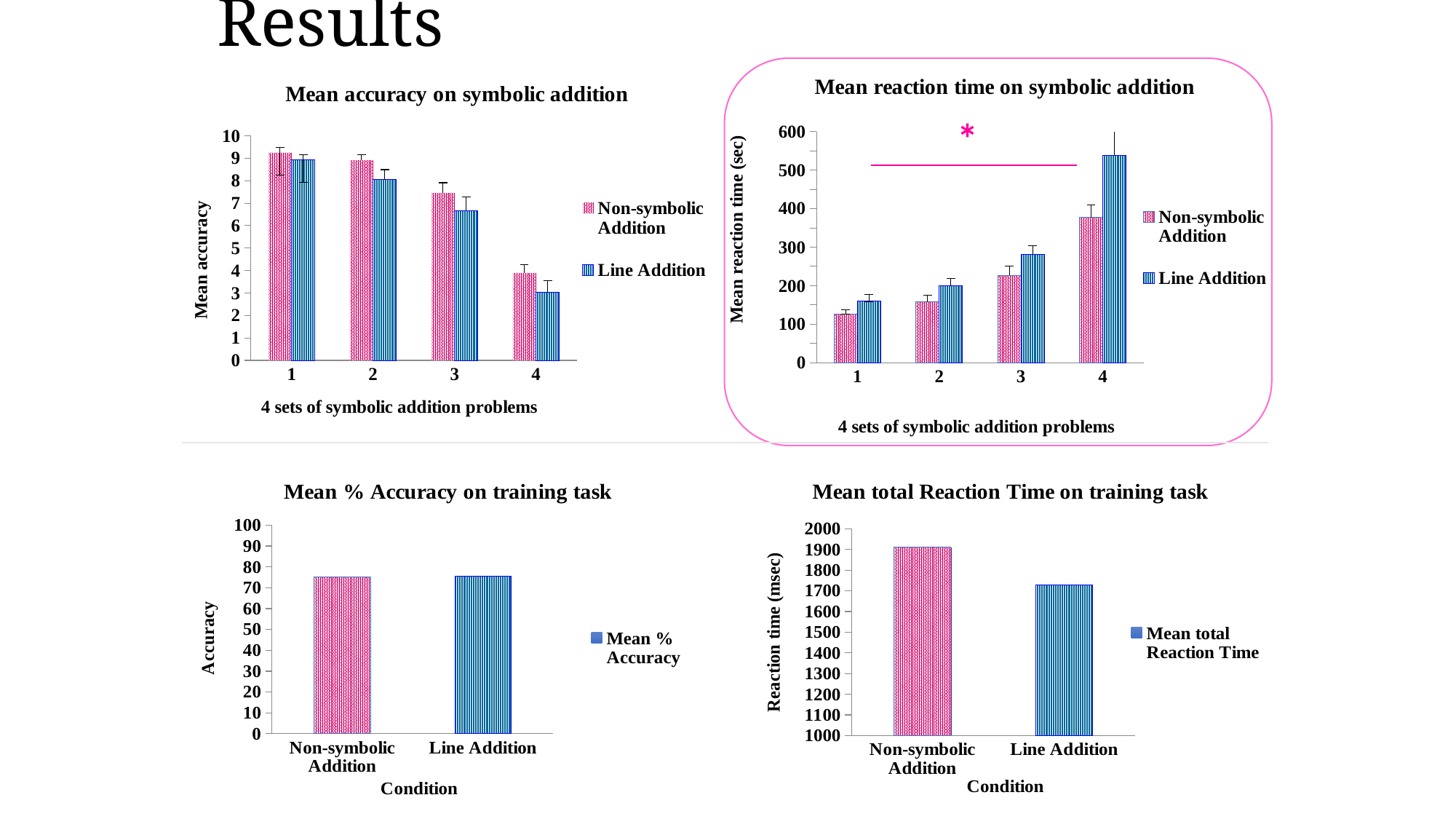
In the 'Mean reaction time on symbolic addition' chart, how many sets of problems are shown on the x axis? 4 In the 'Mean % Accuracy on training task' chart, is the value for Non-symbolic Addition greater or less than 70? greater In the 'Mean accuracy on symbolic addition' chart, is the Non-symbolic Addition value for set 4 greater or less than 5? less In the 'Mean reaction time on symbolic addition' chart, do the Non-symbolic Addition values rise or fall from set 1 to set 4? rise In the 'Mean reaction time on symbolic addition' chart, for set 4, which series has the larger reaction time? Line Addition In the 'Mean accuracy on symbolic addition' chart, do the Line Addition values rise or fall from set 1 to set 4? fall In the 'Mean accuracy on symbolic addition' chart, what kind of chart is shown? bar chart In the 'Mean total Reaction Time on training task' chart, is the value for Line Addition greater or less than 1800? less In the 'Mean accuracy on symbolic addition' chart, how many series does the legend list? 2 In the 'Mean total Reaction Time on training task' chart, which condition has the highest reaction time? Non-symbolic Addition In the 'Mean accuracy on symbolic addition' chart, which set has the lowest Line Addition accuracy? 4